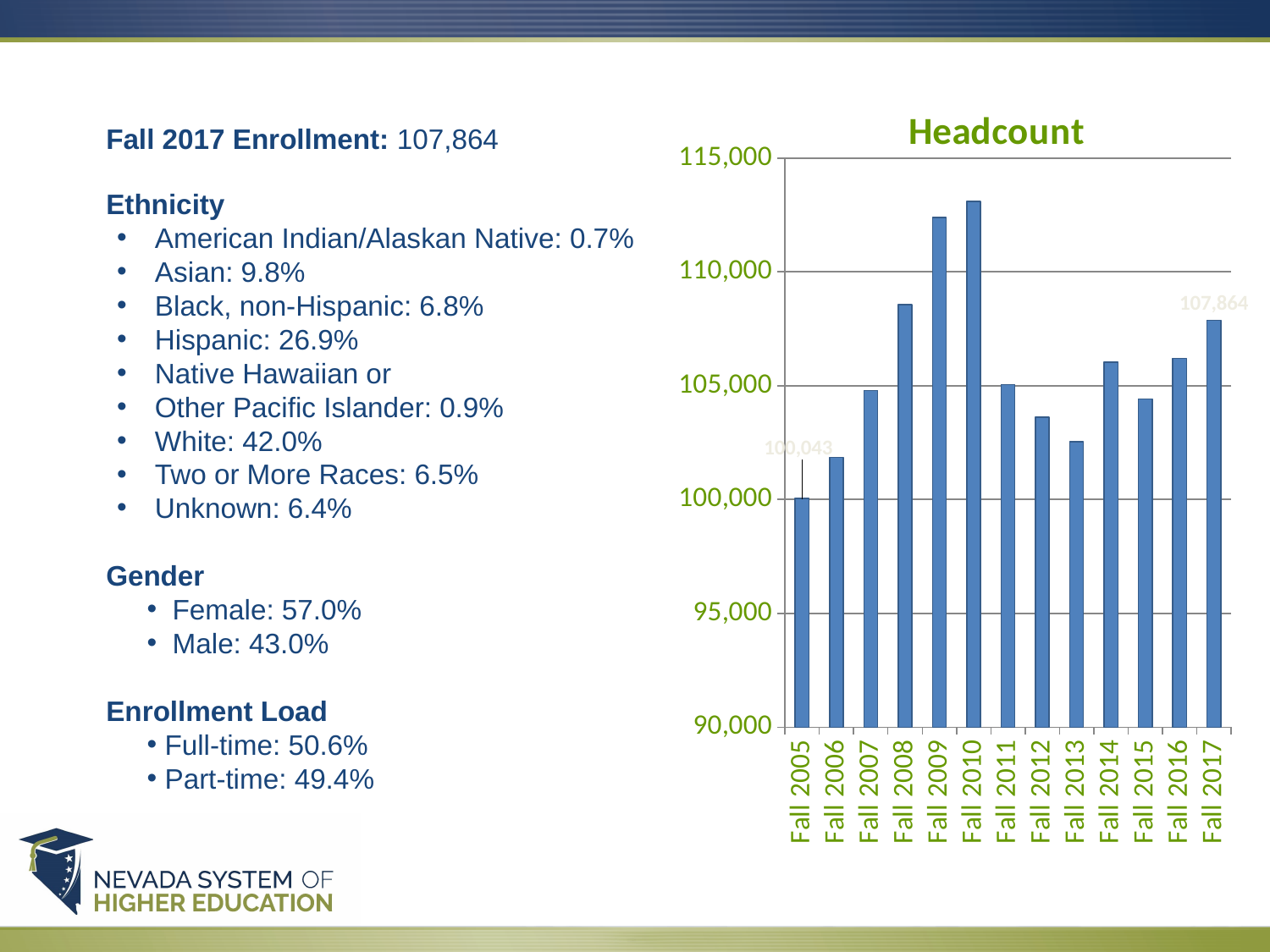
What kind of chart is the Headcount chart? bar chart Which term has the lowest headcount in the chart? Fall 2005 By how much did the headcount in Fall 2017 exceed the headcount in Fall 2005? 7,821 Which term has the highest headcount in the chart? Fall 2010 What is the headcount for Fall 2005 in the Headcount chart? 100,043 Which has the larger headcount, Fall 2012 or Fall 2013? Fall 2012 What is the headcount for Fall 2017 in the Headcount chart? 107,864 How many terms are shown on the x axis of the Headcount chart? 13 Does the headcount rise or fall from Fall 2010 to Fall 2013? fall Is the headcount for Fall 2013 greater or less than 105,000? less Is the headcount for Fall 2008 greater or less than 105,000? greater Which has the larger headcount, Fall 2008 or Fall 2009? Fall 2009